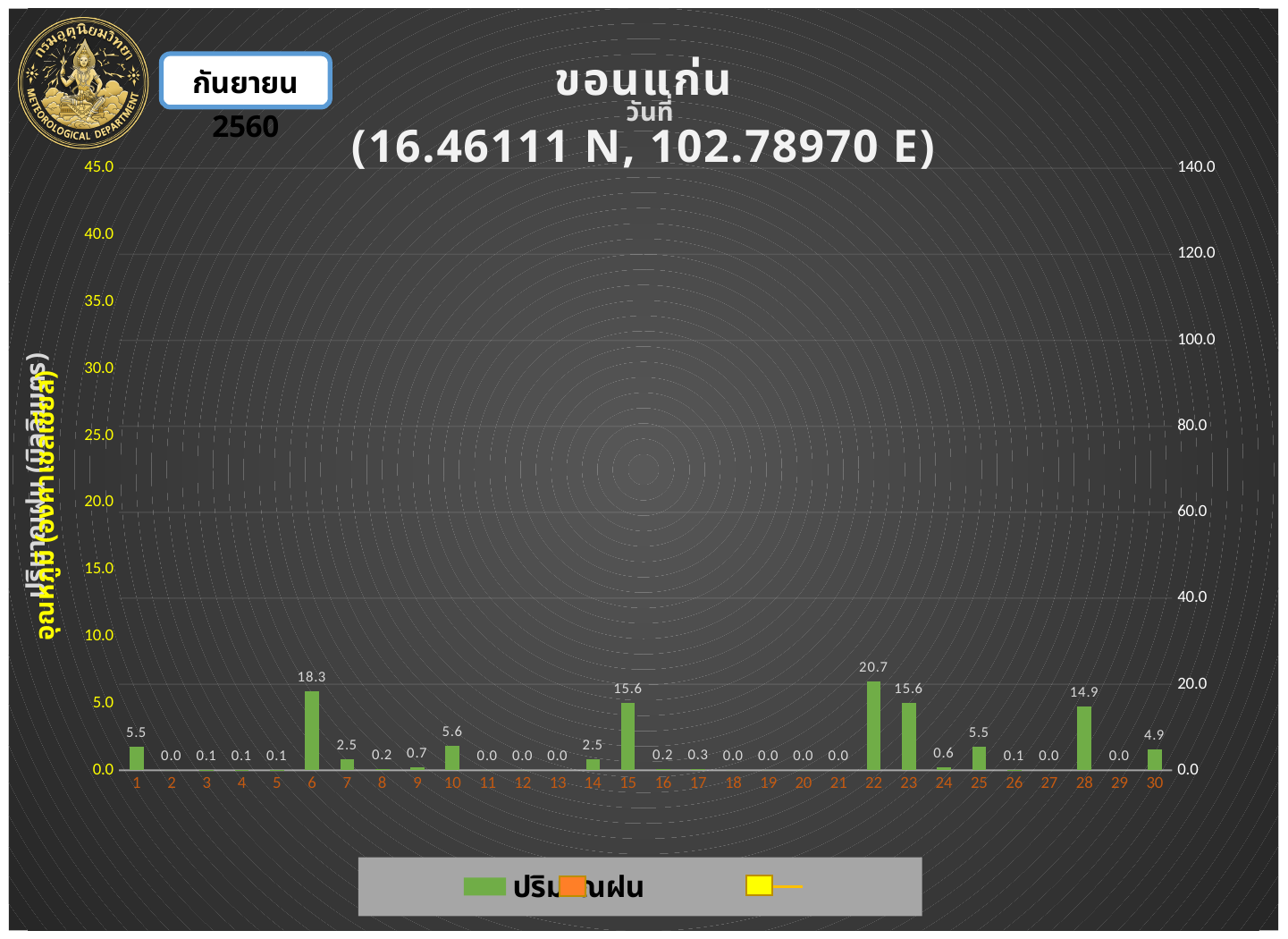
What is the value for day 28? 14.9 What is the value for day 30? 4.9 What coordinates are given in the chart title? 16.46111 N, 102.78970 E How many days are shown on the x axis? 30 What kind of chart is shown on the slide? bar chart What is the value for day 22? 20.7 What is the difference between the values for day 23 and day 25? 10.1 What is the value for day 6? 18.3 What is the difference between the values for day 22 and day 6? 2.4 Which is larger, the value for day 15 or the value for day 28? day 15 Which is larger, the value for day 7 or the value for day 9? day 7 Which day has the highest value? 22